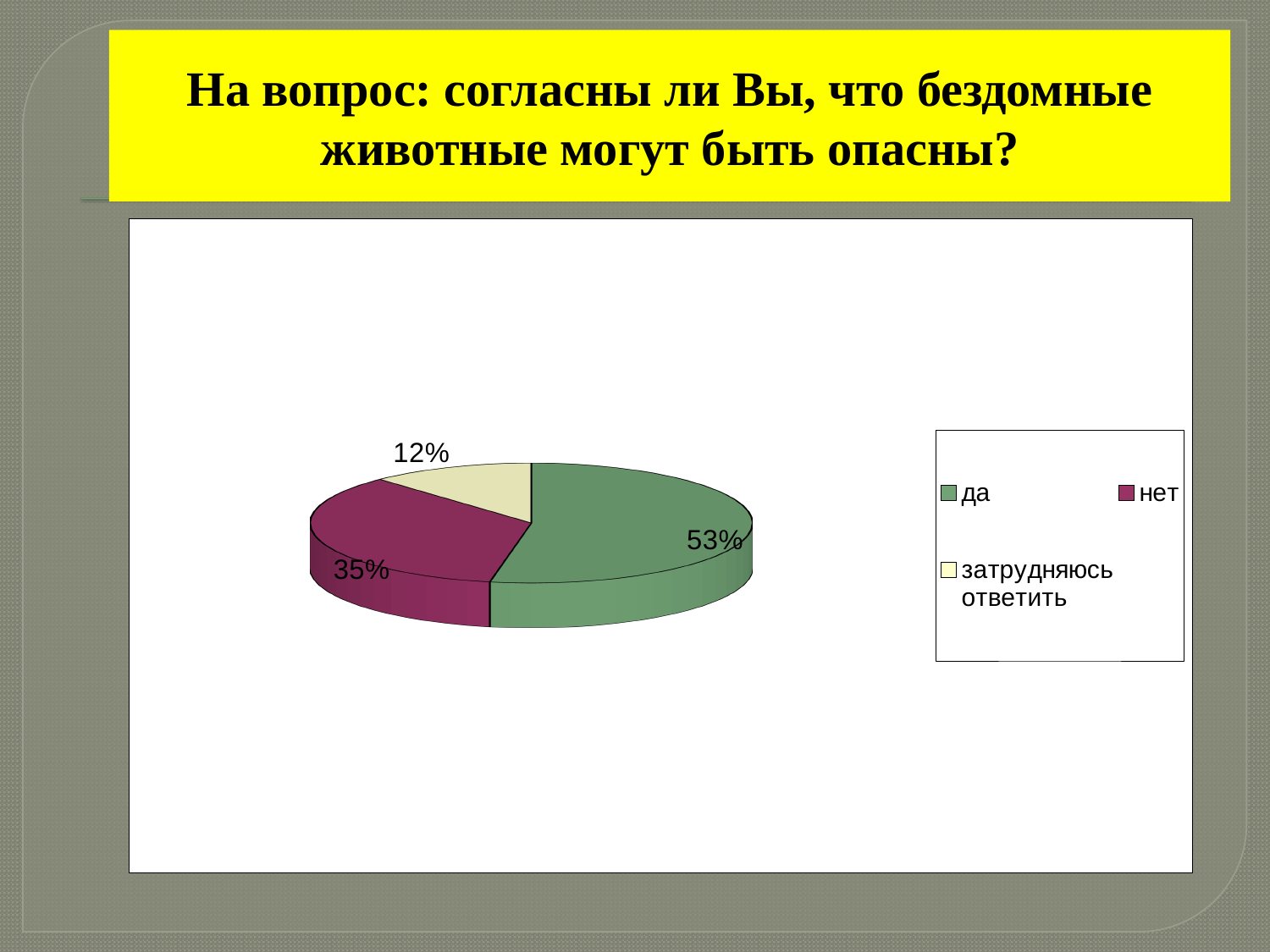
How many entries does the legend list? 3 What share of the pie does "затрудняюсь ответить" take? 12% Which category has the largest slice of the pie? да What colour is the slice for "нет"? purple What is the difference in percentage points between "нет" and "затрудняюсь ответить"? 23 What share of the pie does "да" take? 53% What share of the pie does "нет" take? 35% What is the difference in percentage points between "да" and "нет"? 18 Which is larger, the slice for "да" or the slice for "нет"? да What kind of chart is shown on the slide? pie chart Which category has the smallest slice of the pie? затрудняюсь ответить How many slices does the pie chart have? 3